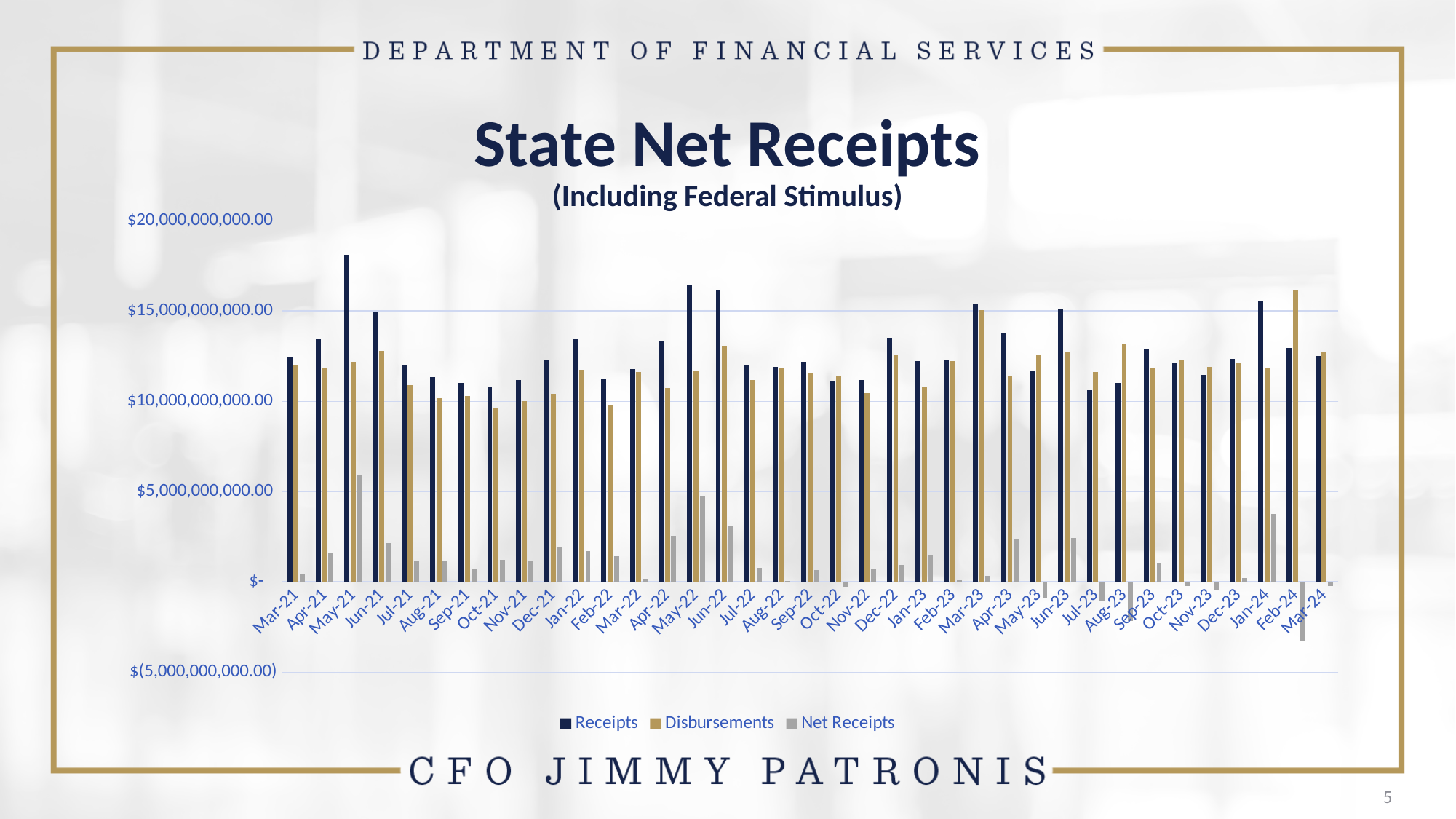
Which month has the highest Disbursements value? Feb-24 Which is larger: Net Receipts for May-21 or Net Receipts for May-22? May-21 How many series does the legend list? 3 How many months are shown on the x axis? 37 Is the Receipts value for May-21 greater or less than $15,000,000,000.00? greater What kind of chart is shown on the slide? Bar chart Which month has the lowest Net Receipts value? Feb-24 Which month has the highest Receipts value? May-21 What is the subtitle shown under the chart title 'State Net Receipts'? (Including Federal Stimulus) In Feb-24, which is larger: Receipts or Disbursements? Disbursements Is the Disbursements value for Oct-21 greater or less than $10,000,000,000.00? less Is the Receipts value for Jul-23 greater or less than $15,000,000,000.00? less